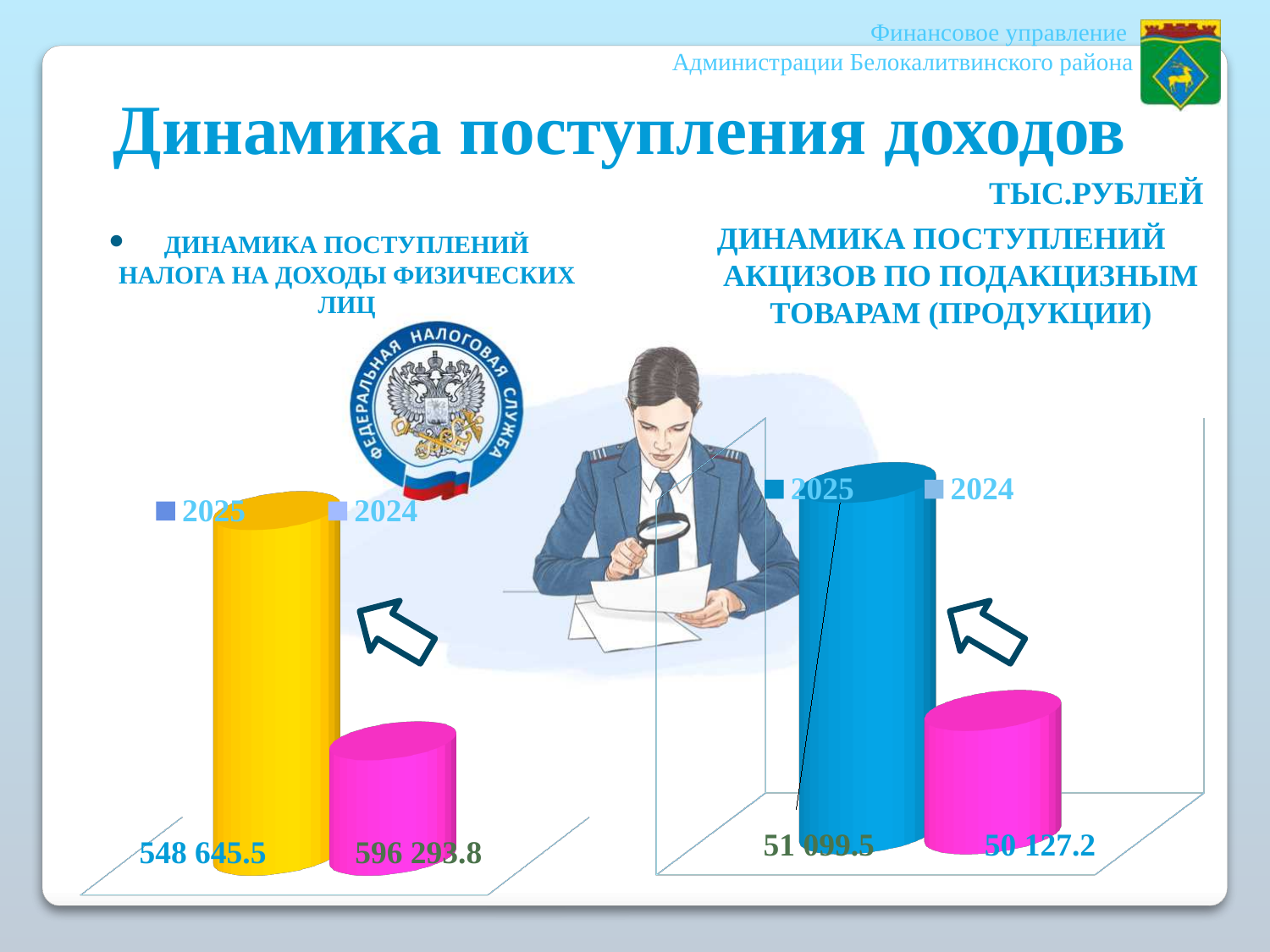
In the right chart (акцизы по подакцизным товарам), which bar is taller, the blue one or the pink one? the blue one How many series does the legend of the left chart (налог на доходы физических лиц) list? 2 In the right chart (акцизы по подакцизным товарам), what value is printed under the pink bar? 50 127.2 In the left chart (налог на доходы физических лиц), what is the difference between the two printed values, 596 293.8 and 548 645.5? 47 648.3 In the left chart (налог на доходы физических лиц), what value is printed under the pink bar? 596 293.8 In the right chart (акцизы по подакцизным товарам), what value is printed under the blue bar? 51 099.5 In the right chart (акцизы по подакцизным товарам), what is the difference between the two printed values, 51 099.5 and 50 127.2? 972.3 What years are listed in the legend of the right chart (акцизы по подакцизным товарам)? 2025 and 2024 What kind of chart is shown on the left under the heading about налог на доходы физических лиц? bar chart What unit of measurement is stated on the slide for the chart values? ТЫС.РУБЛЕЙ In the left chart (налог на доходы физических лиц), what value is printed under the yellow bar? 548 645.5 How many bars are plotted in the left chart (налог на доходы физических лиц)? 2